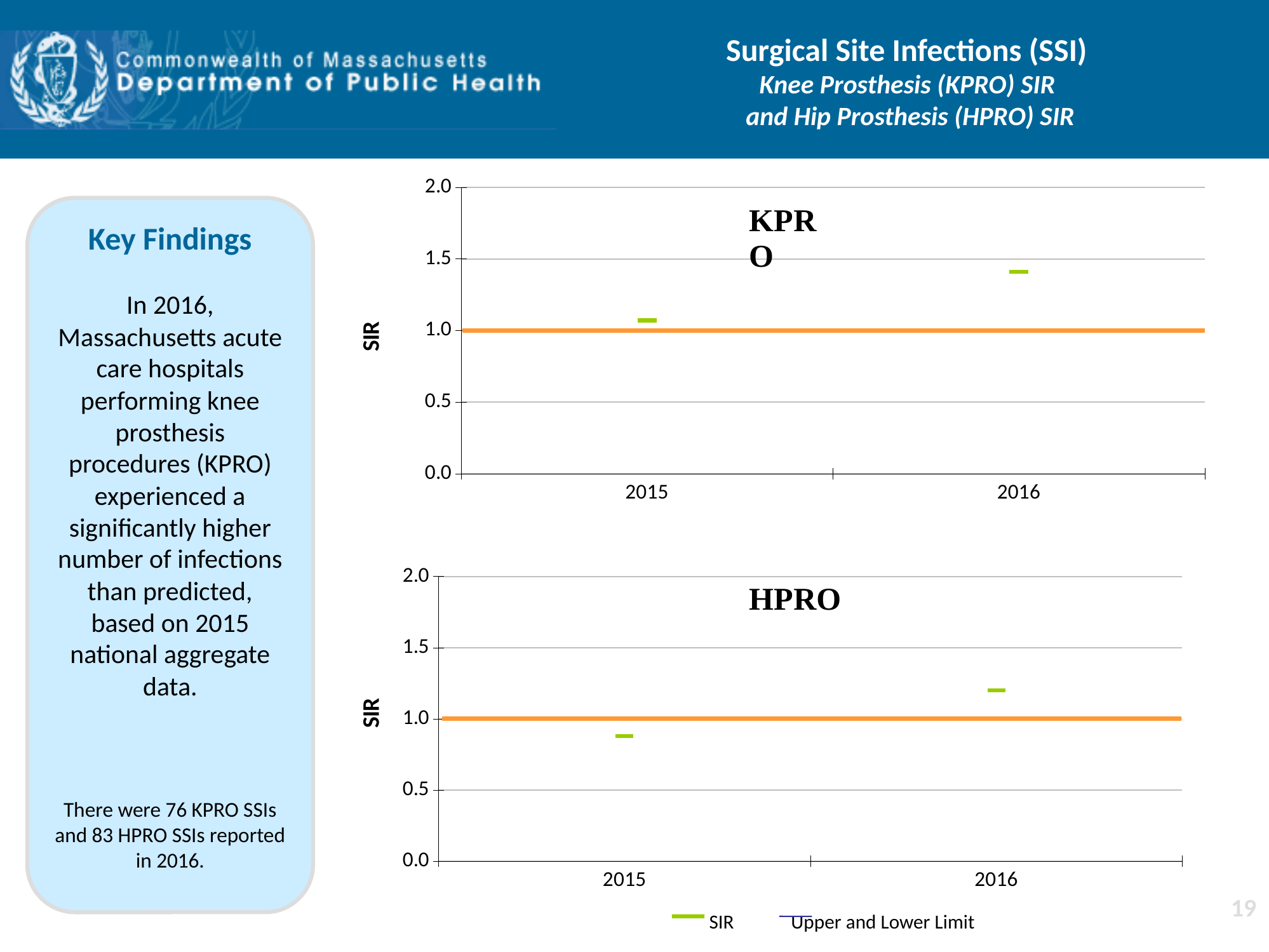
In the KPRO chart, which year has the higher SIR, 2015 or 2016? 2016 In the HPRO chart, does the SIR rise or fall from 2015 to 2016? rise In the KPRO chart, is the SIR value for 2016 greater or less than 1.5? less How many series does the legend at the bottom of the slide list? 2 In the HPRO chart, is the SIR value for 2016 greater or less than 1.0? greater In the HPRO chart, is the SIR value for 2015 greater or less than 1.0? less In the HPRO chart, which year has the lower SIR, 2015 or 2016? 2015 What is the label on the y axis of the KPRO chart? SIR In the KPRO chart, does the SIR rise or fall from 2015 to 2016? rise How many years are plotted on the x axis of the HPRO chart? 2